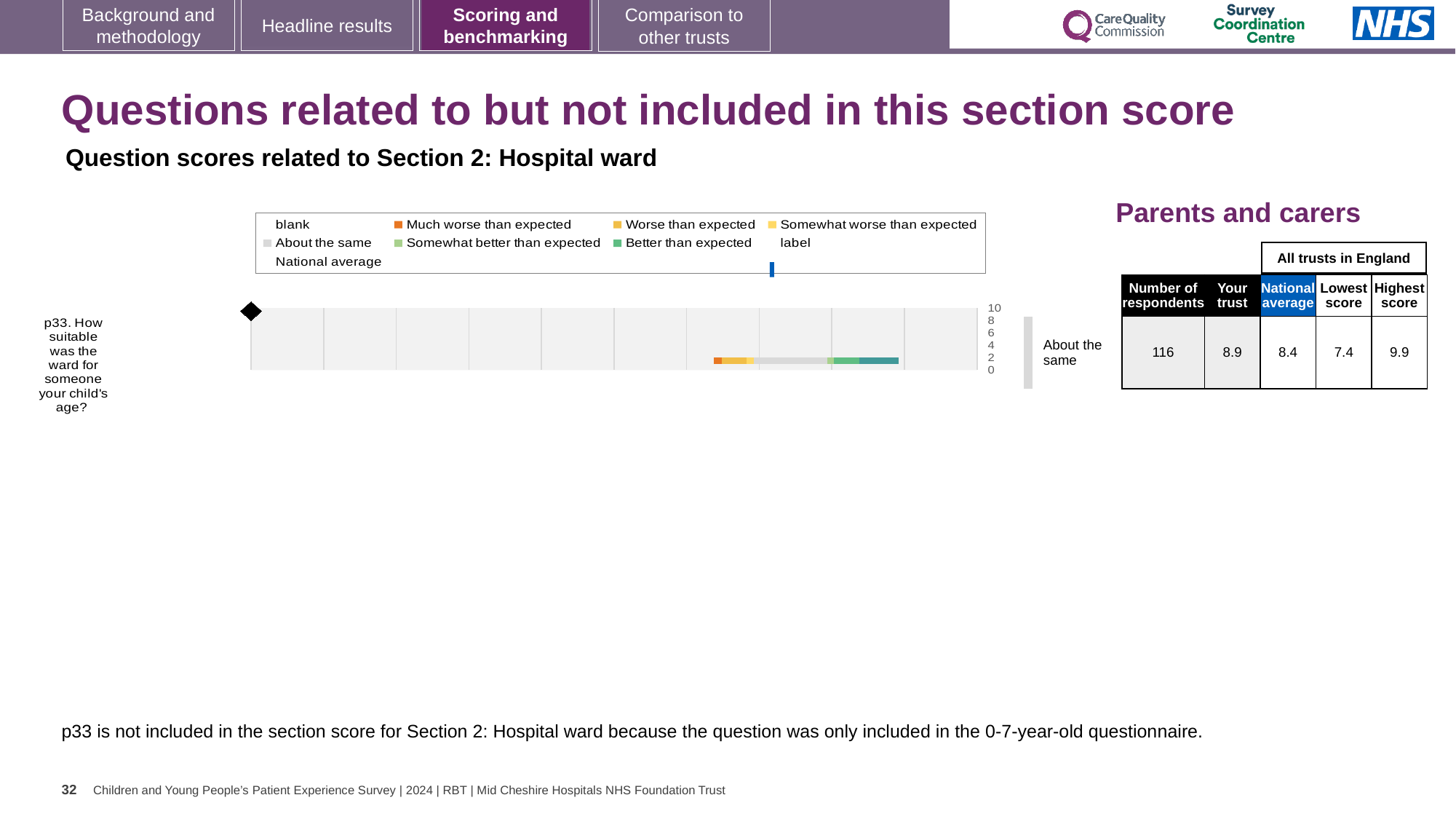
What is the lowest score among all trusts in England for p33? 7.4 How many questions are plotted in the chart? 1 What is the difference between the highest score and the lowest score for p33? 2.5 Which is higher for p33, the 'Your trust' score or the national average? Your trust What is the difference between the 'Your trust' score and the national average for p33? 0.5 What is the question label shown for the plotted bar? p33. How suitable was the ward for someone your child's age? What is the 'Your trust' score for p33 in the table next to the chart? 8.9 What benchmark category is shown to the right of the p33 bar? About the same How many respondents answered p33? 116 What is the highest score among all trusts in England for p33? 9.9 What type of chart is used to show the p33 question score? bar chart What is the national average score for p33? 8.4